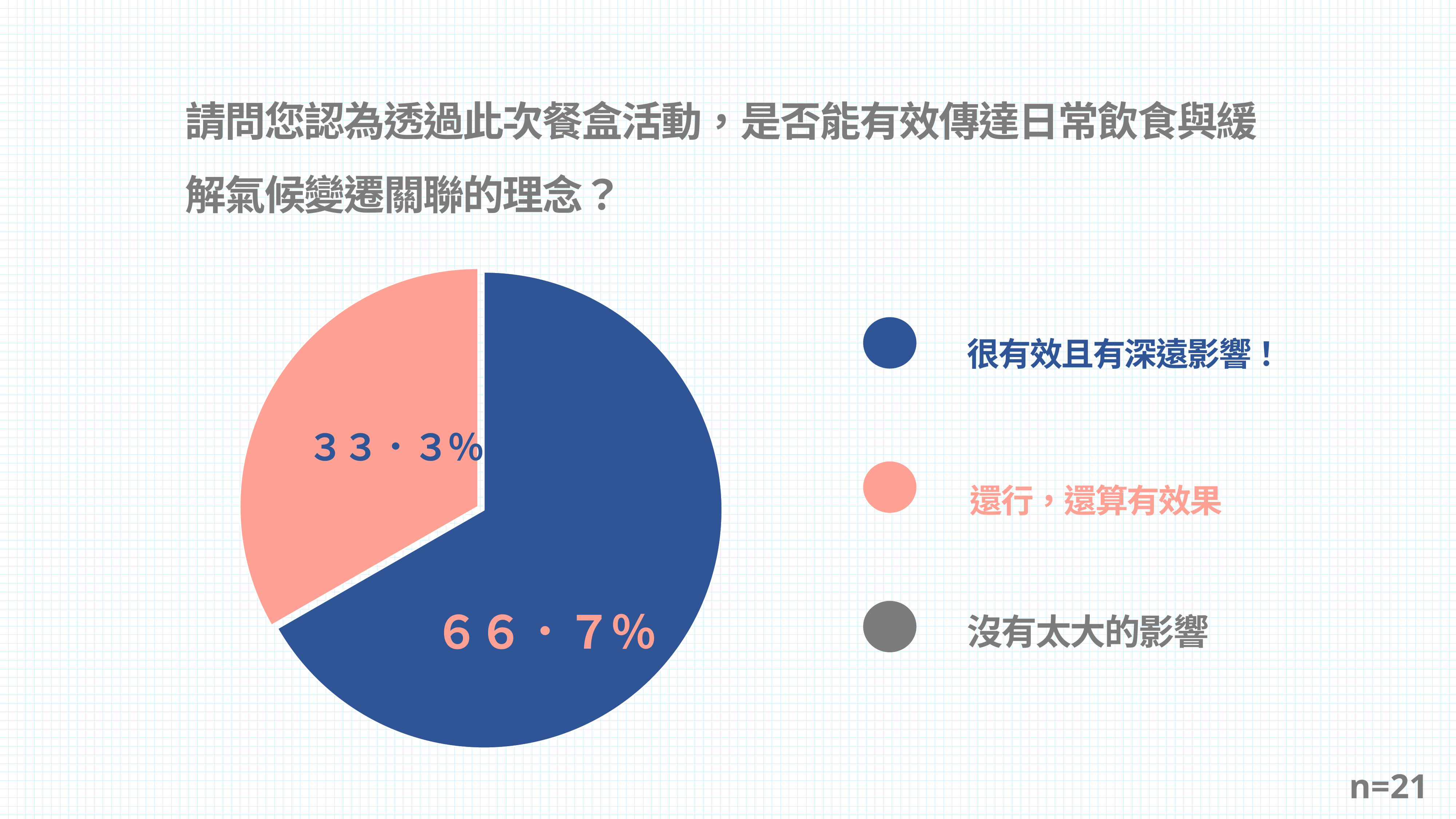
How many entries does the legend list? 3 Which is larger: the slice for 很有效且有深遠影響！ or the slice for 還行，還算有效果? 很有效且有深遠影響！ Which response has the largest slice of the pie? 很有效且有深遠影響！ What colour represents 很有效且有深遠影響！ in the pie chart? blue How many slices are visible in the pie chart? 2 What do the two labelled slices of the pie add up to? 100% What is the difference in percentage points between the 很有效且有深遠影響！ slice and the 還行，還算有效果 slice? 33.4 percentage points Of the two slices shown in the pie, which is the smaller one? 還行，還算有效果 What kind of chart is shown on the slide? pie chart What is the sample size (n) shown on the slide? n=21 What share of the pie does 還行，還算有效果 take? 33.3% What share of the pie does 很有效且有深遠影響！ take? 66.7%